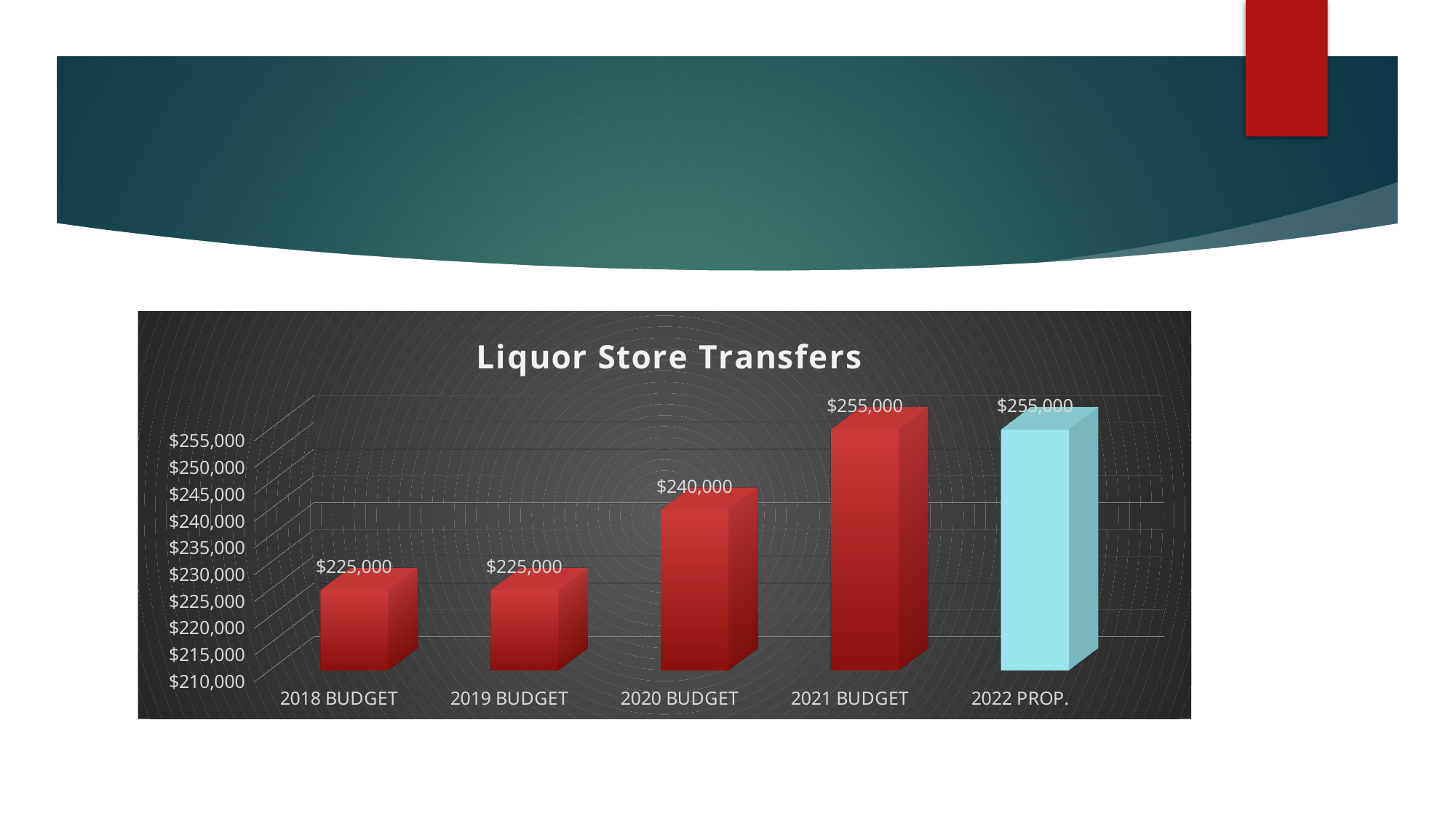
Do the values in the Liquor Store Transfers chart generally rise or fall from 2018 BUDGET to 2022 PROP.? Rise Which category has the lowest value in the Liquor Store Transfers chart? 2018 BUDGET and 2019 BUDGET (both $225,000) What is the difference between the 2020 BUDGET and 2019 BUDGET values in the Liquor Store Transfers chart? $15,000 What is the title of the chart on the slide? Liquor Store Transfers How many categories are shown in the Liquor Store Transfers chart? 5 What is the difference between the 2021 BUDGET and 2020 BUDGET values in the Liquor Store Transfers chart? $15,000 What is the value for 2022 PROP. in the Liquor Store Transfers chart? $255,000 What is the value for 2020 BUDGET in the Liquor Store Transfers chart? $240,000 What is the value for 2018 BUDGET in the Liquor Store Transfers chart? $225,000 Which is larger in the Liquor Store Transfers chart, the 2020 BUDGET value or the 2019 BUDGET value? 2020 BUDGET What is the value for 2021 BUDGET in the Liquor Store Transfers chart? $255,000 What kind of chart is the Liquor Store Transfers chart? Bar chart